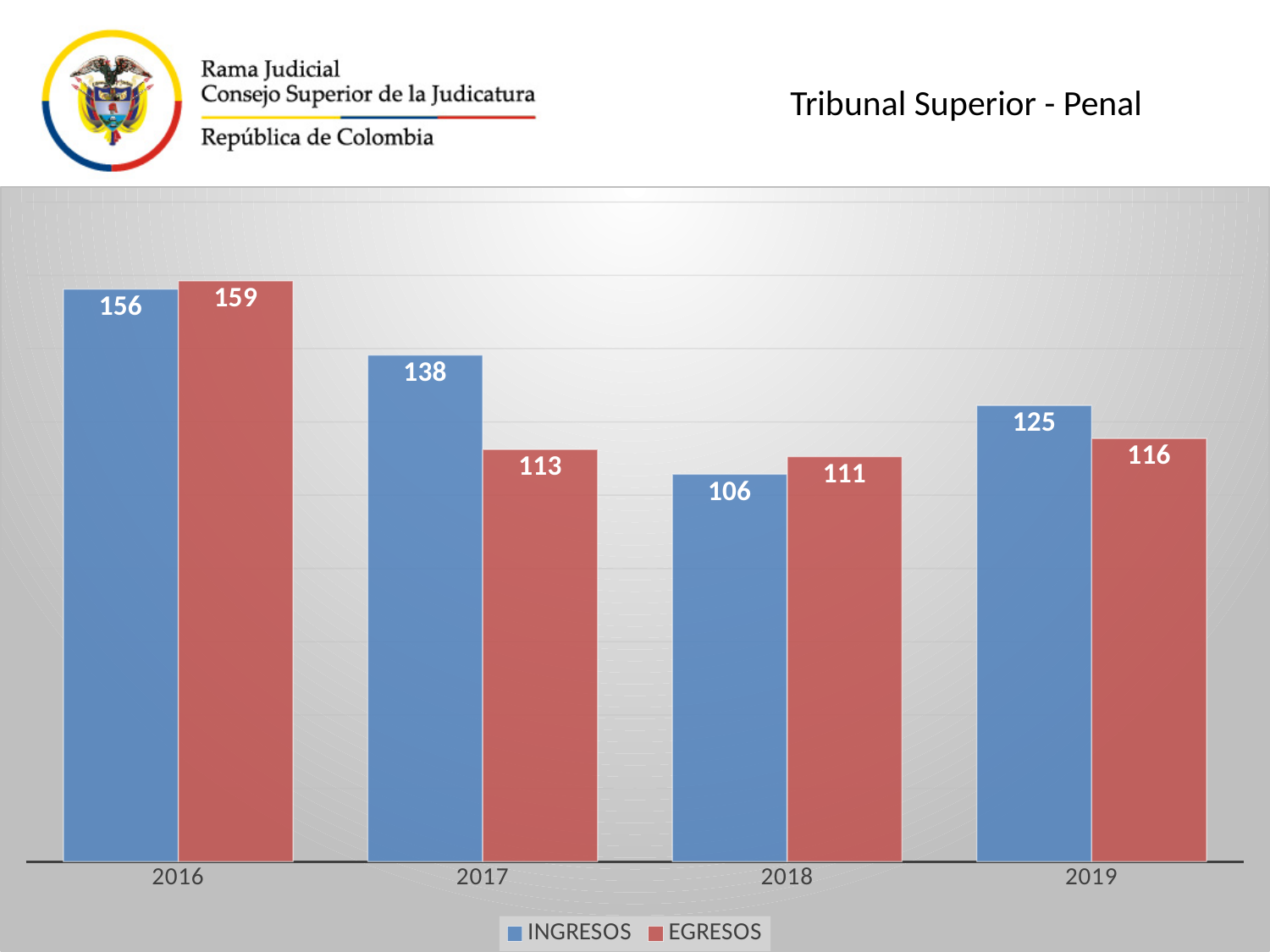
How many series does the legend list? 2 What is the INGRESOS value for 2018? 106 Does the INGRESOS series rise or fall from 2016 to 2018? Fall What is the INGRESOS value for 2017? 138 Which is larger in 2018, INGRESOS or EGRESOS? EGRESOS What is the difference between the INGRESOS values for 2016 and 2019? 31 Which year has the highest EGRESOS value? 2016 What is the EGRESOS value for 2019? 116 What is the difference between INGRESOS and EGRESOS in 2017? 25 How many years are shown on the x axis? 4 Which year has the lowest INGRESOS value? 2018 What kind of chart is shown on the slide? Bar chart